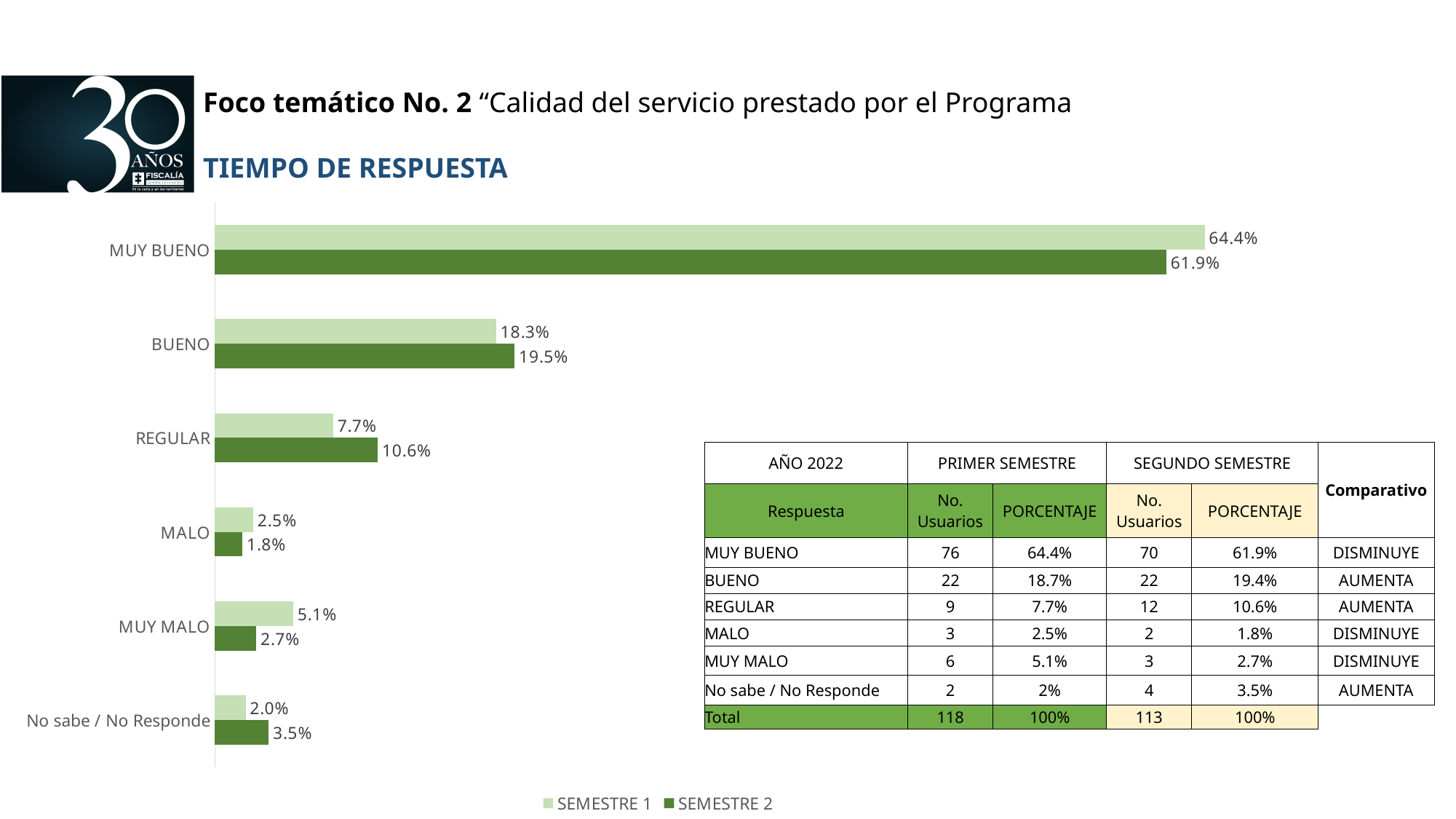
What is the difference between the SEMESTRE 1 and SEMESTRE 2 values for MUY BUENO? 2.5% What is the difference between the SEMESTRE 1 and SEMESTRE 2 values for MUY MALO? 2.4% Which is larger for MALO, the SEMESTRE 1 value or the SEMESTRE 2 value? SEMESTRE 1 How many series does the legend list? 2 What is the SEMESTRE 2 value for REGULAR? 10.6% What is the SEMESTRE 1 value for MUY BUENO? 64.4% What kind of chart is shown on the slide? Bar chart What is the SEMESTRE 2 value for No sabe / No Responde? 3.5% Which is larger for BUENO, the SEMESTRE 1 value or the SEMESTRE 2 value? SEMESTRE 2 Which category has the lowest SEMESTRE 2 value? MALO Which category has the highest SEMESTRE 1 value? MUY BUENO How many categories are shown on the chart? 6